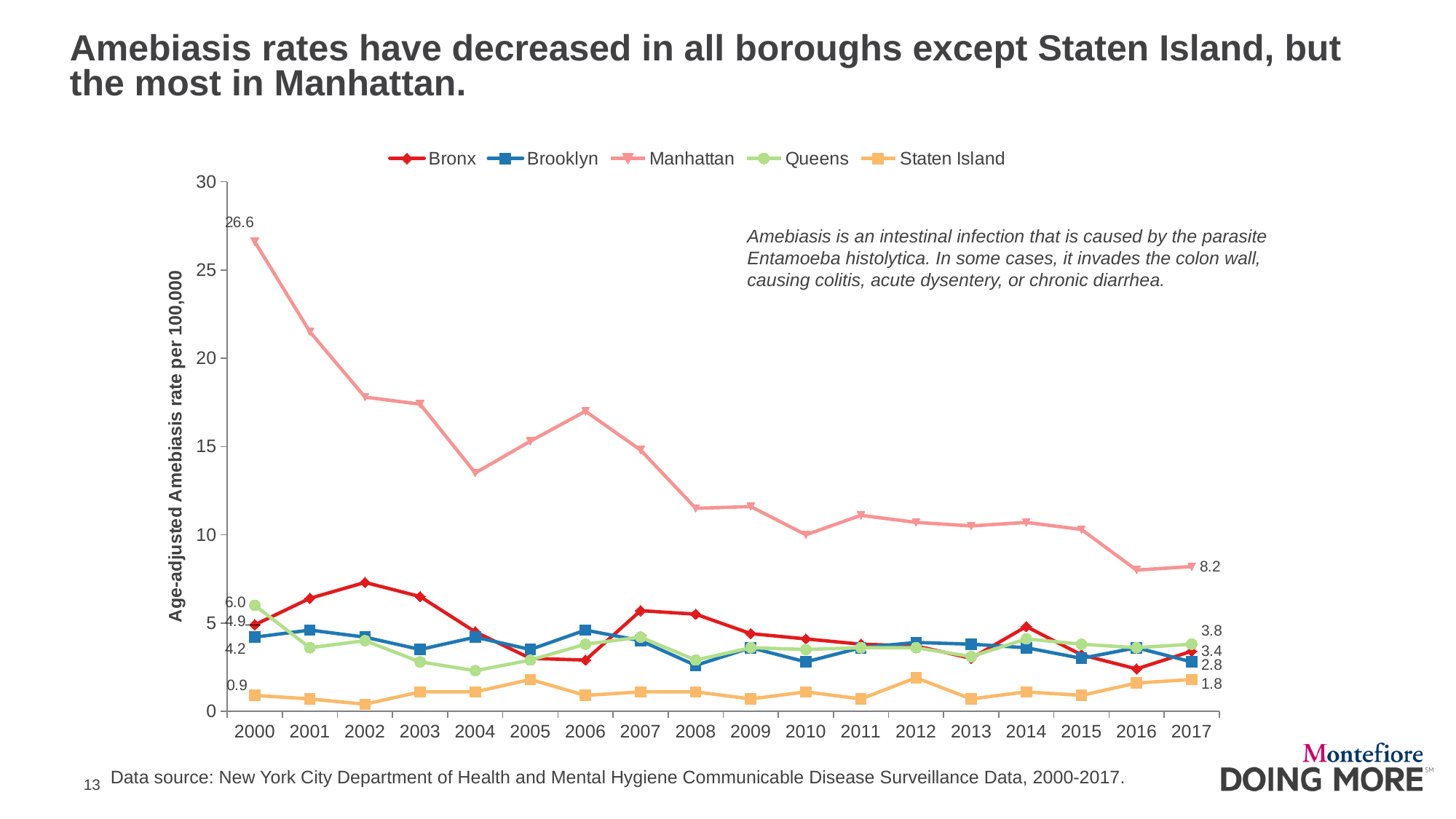
By how much did Manhattan's amebiasis rate decrease from 2000 to 2017? 18.4 Does the Manhattan line generally rise or fall from 2000 to 2017? Fall How many years are plotted along the x axis? 18 What was the age-adjusted amebiasis rate for Staten Island in 2000? 0.9 Which borough had the lowest amebiasis rate in 2000? Staten Island What was the age-adjusted amebiasis rate for Manhattan in 2000? 26.6 What type of chart is shown on the slide? Line chart Is the value for Manhattan in 2004 greater or less than 15? less Which borough had the highest amebiasis rate in 2000? Manhattan What was the age-adjusted amebiasis rate for Queens in 2000? 6.0 What was the age-adjusted amebiasis rate for Manhattan in 2017? 8.2 How many series does the legend list? 5